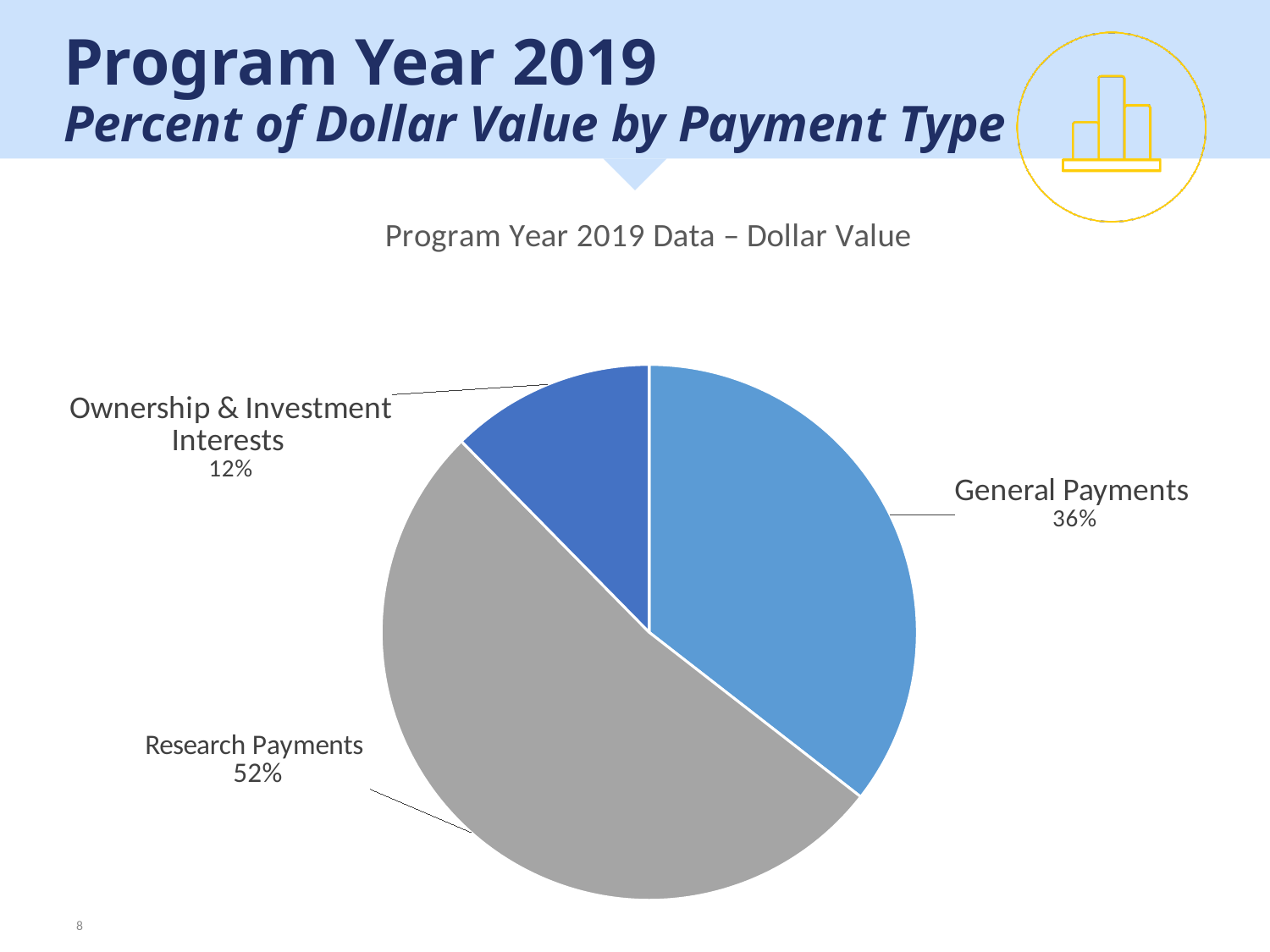
Which payment type has the smallest share of the dollar value? Ownership & Investment Interests What is the difference in percentage points between General Payments and Ownership & Investment Interests? 24 Which payment type has the largest share of the dollar value? Research Payments What percentage of the dollar value is attributed to General Payments? 36% What type of chart is shown on the slide? Pie chart What is the difference in percentage points between Research Payments and General Payments? 16 What percentage of the dollar value is attributed to Research Payments? 52% What percentage of the dollar value is attributed to Ownership & Investment Interests? 12% What is the title of the chart? Program Year 2019 Data – Dollar Value What colour is the Research Payments slice? Gray How many payment types are shown in the pie chart? 3 Which has a larger share of the dollar value, General Payments or Ownership & Investment Interests? General Payments